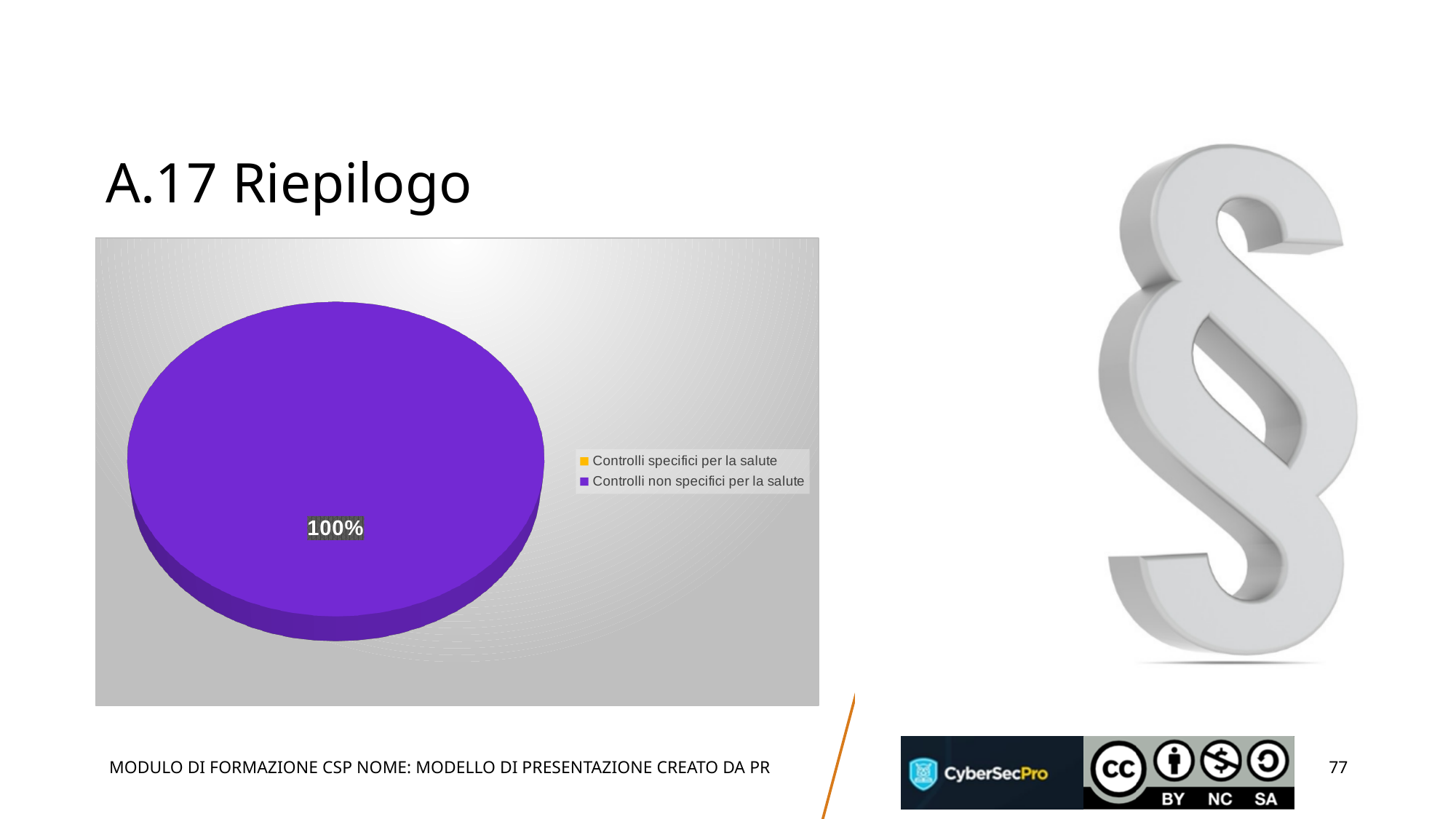
How many slices are visibly drawn in the pie chart? 1 How many entries does the legend of the pie chart list? 2 What kind of chart is shown on the slide? pie chart Which category has the largest slice in the pie chart? Controlli non specifici per la salute Which of the two legend categories has the larger share of the pie: 'Controlli specifici per la salute' or 'Controlli non specifici per la salute'? Controlli non specifici per la salute What is the only data label printed on the pie chart? 100% What colour is the slice labelled 100% in the pie chart? purple Which legend entry is shown in yellow? Controlli specifici per la salute What share of the pie does the 'Controlli non specifici per la salute' slice represent? 100%